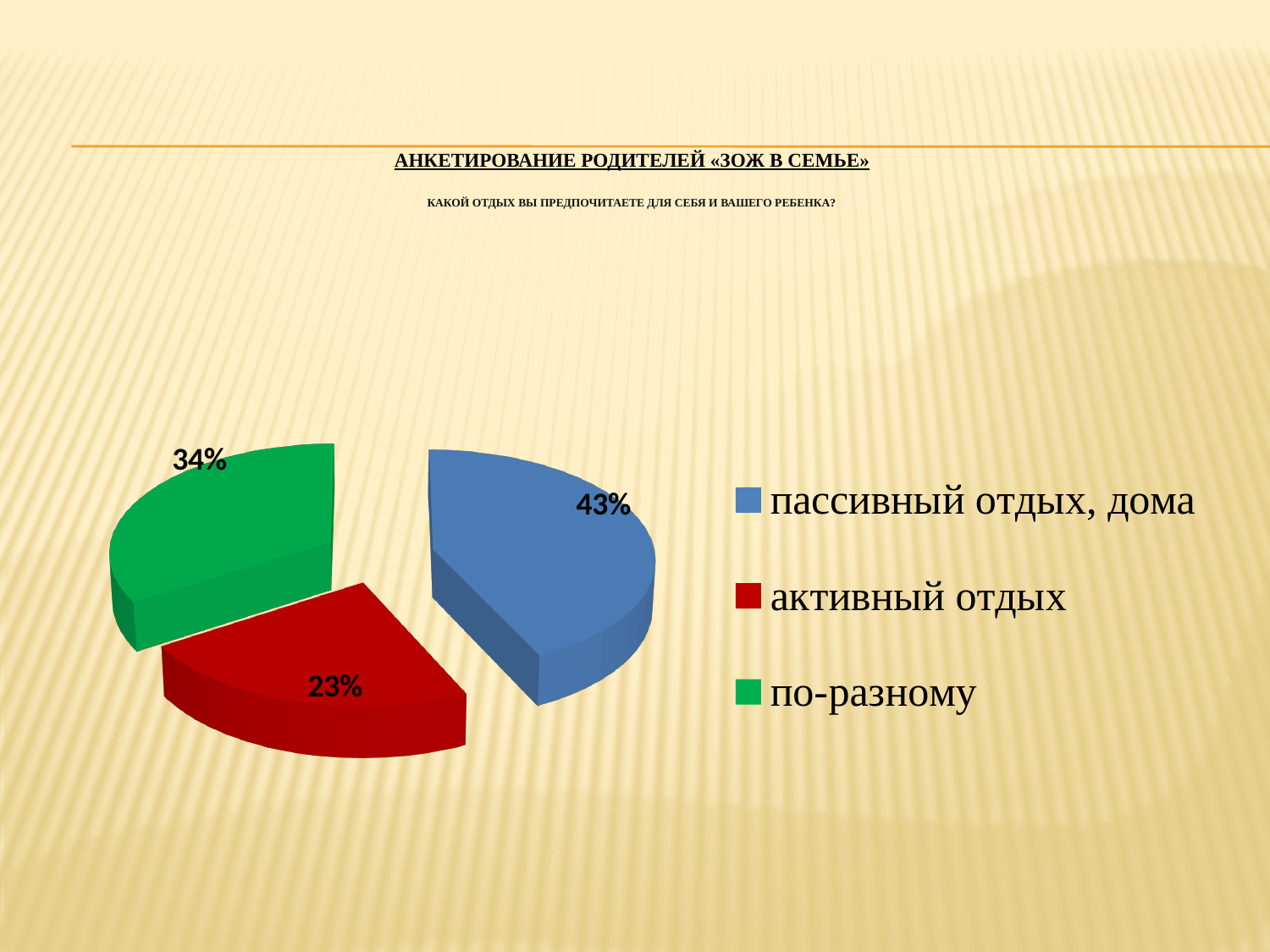
What kind of chart is shown on the slide? pie chart What is the difference in percentage points between «пассивный отдых, дома» and «активный отдых»? 20 What colour is the slice for «активный отдых»? red Which category has the largest share of the pie? пассивный отдых, дома Which category has the smallest share of the pie? активный отдых What share of the pie is labelled for «по-разному»? 34% What is the difference in percentage points between «по-разному» and «активный отдых»? 11 What share of the pie is labelled for «пассивный отдых, дома»? 43% How many slices does the pie chart have? 3 What share of the pie is labelled for «активный отдых»? 23% Which is larger: the share for «по-разному» or the share for «активный отдых»? по-разному Which legend entry is shown in green? по-разному